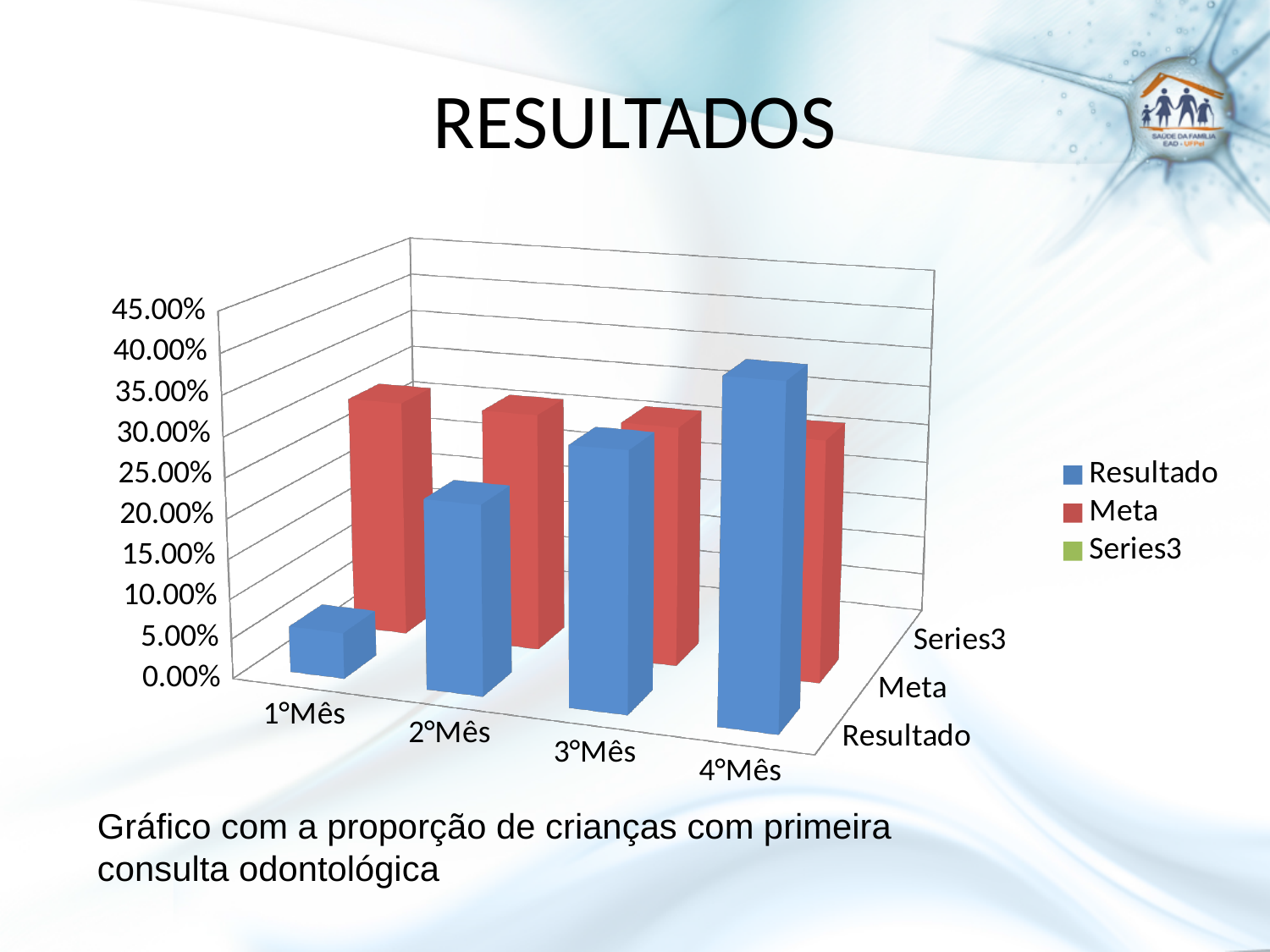
What kind of chart is shown on the slide? bar chart How many series does the legend list? 3 Is the Resultado value for 4°Mês greater or less than 30.00%? greater In which month is the Resultado value lowest? 1°Mês Is the Resultado value for 1°Mês greater or less than 10.00%? less Do the Resultado values rise or fall from 1°Mês to 4°Mês? rise What colour represents the Resultado series in the legend? blue How many month categories are shown on the x axis? 4 In which month is the Resultado value highest? 4°Mês Which is larger, the Resultado value for 4°Mês or the Resultado value for 1°Mês? 4°Mês Which is larger at 1°Mês, the Resultado value or the Meta value? Meta